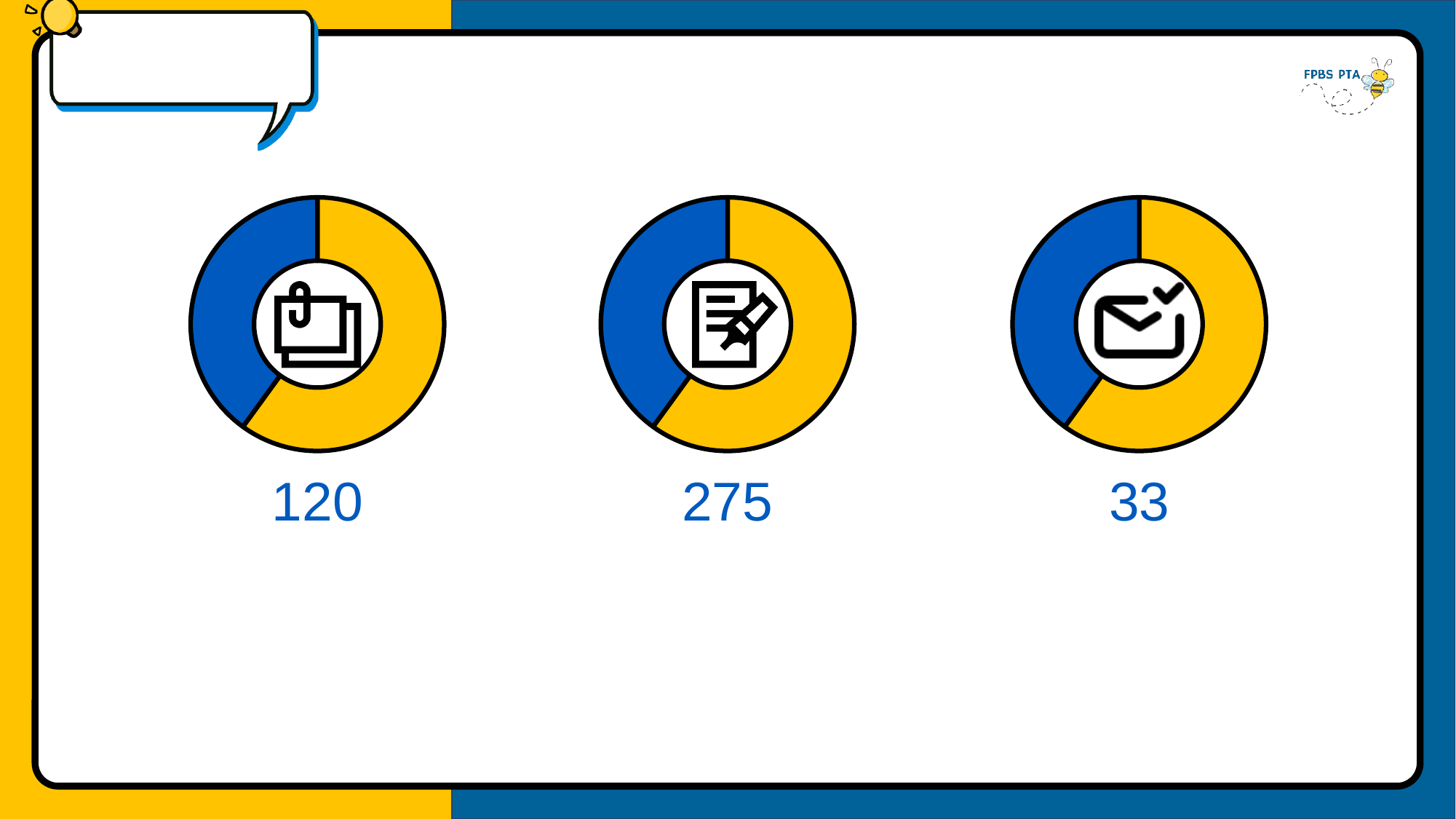
How many slices does each donut chart on the slide have? 2 What number is shown below the middle donut chart? 275 Which donut chart (left, middle or right) has the lowest number shown below it? right What two colours are used for the slices in the donut charts? yellow and blue Which donut chart (left, middle or right) has the highest number shown below it? middle What is the difference between the number below the left donut chart and the number below the right donut chart? 87 How many donut charts are shown on the slide? 3 What number is shown below the right donut chart? 33 What kind of chart is used for each of the three figures on the slide? donut chart What is the difference between the number below the middle donut chart and the number below the left donut chart? 155 Is the number below the left donut chart larger or smaller than the number below the right donut chart? larger What number is shown below the left donut chart? 120